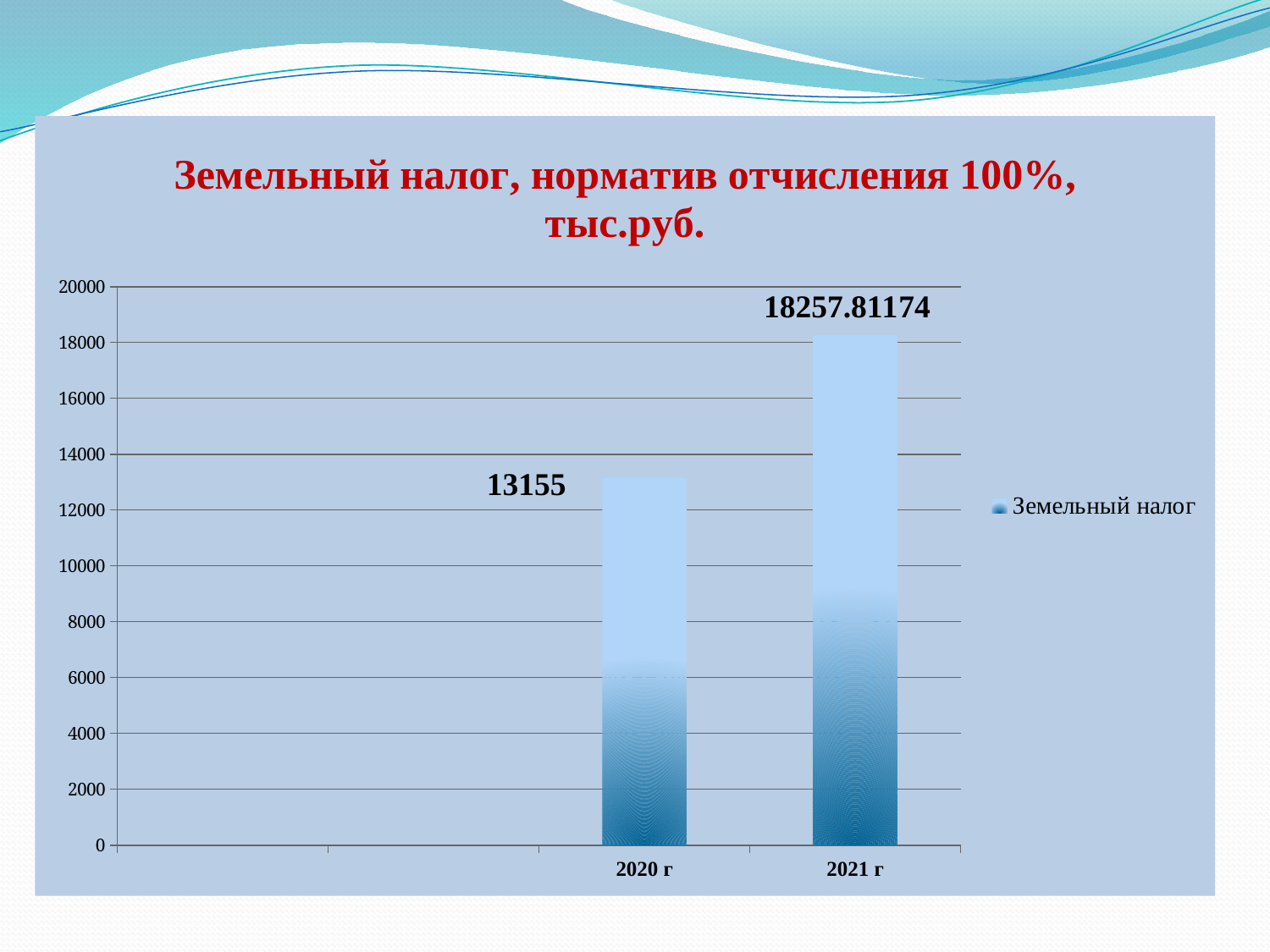
What kind of chart is shown? bar chart Is the value for 2021 г greater or less than 18000? greater How many series does the legend list? 1 How many categories are shown on the x axis? 2 Which is larger, the value for 2020 г or the value for 2021 г? 2021 г What is the value for 2020 г? 13155 Which year has the highest value? 2021 г Is the value for 2020 г greater or less than 14000? less What is the value for 2021 г? 18257.81174 Which year has the lowest value? 2020 г What is the difference between the values for 2021 г and 2020 г? 5102.81174 Do the values rise or fall from 2020 г to 2021 г? rise